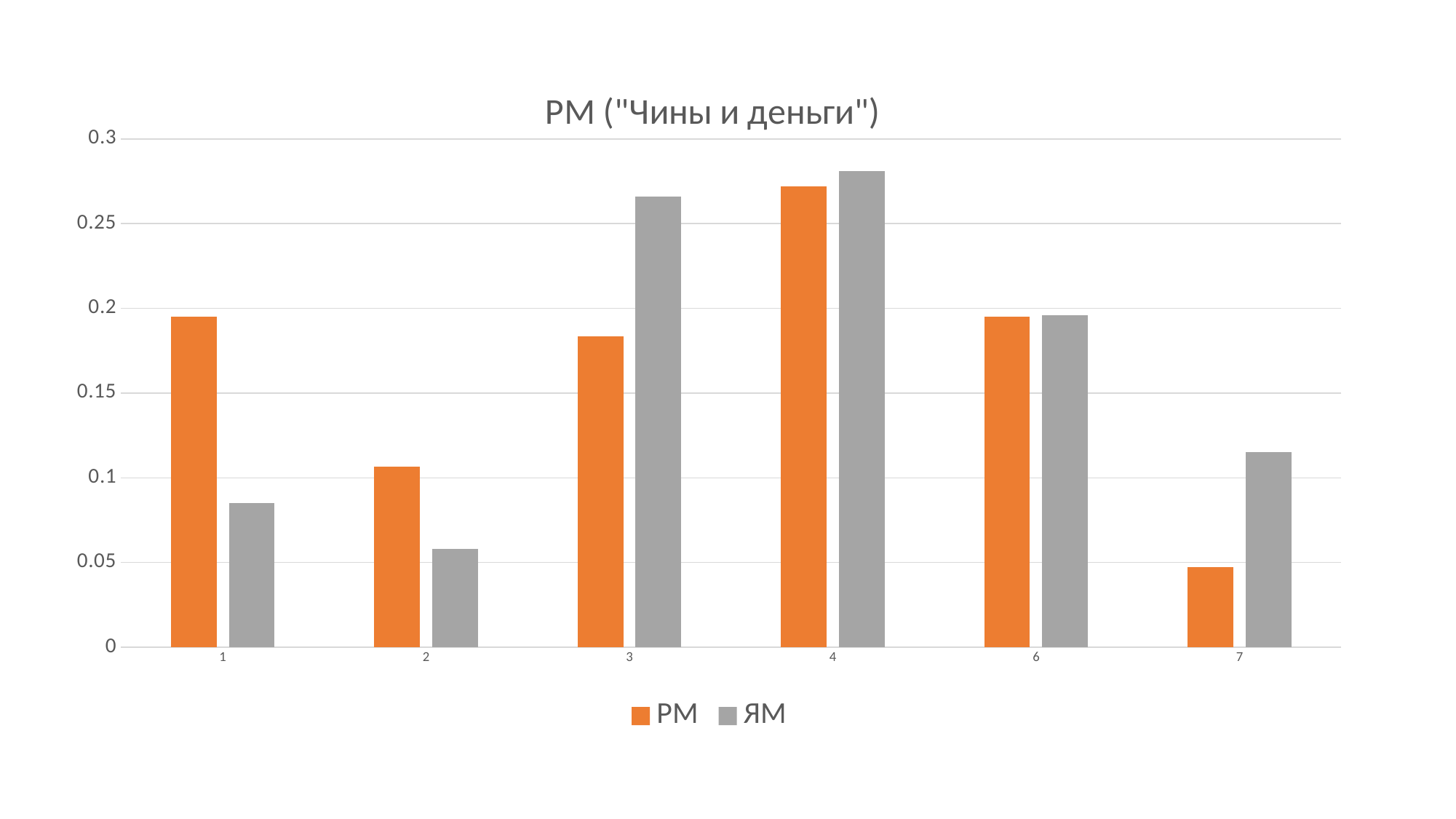
Which category has the lowest value for the РМ series? 7 What kind of chart is shown on the slide? bar chart In category 7, which series has the larger value, РМ or ЯМ? ЯМ How many categories are shown on the x axis? 6 Is the value for ЯМ in category 2 greater or less than 0.1? less How many series does the legend list? 2 Is the value for РМ in category 4 greater or less than 0.25? greater In category 1, which series has the larger value, РМ or ЯМ? РМ Which colour represents the ЯМ series? gray Which category has the highest value for the РМ series? 4 Which category has the lowest value for the ЯМ series? 2 What is the title of the chart? РМ ("Чины и деньги")